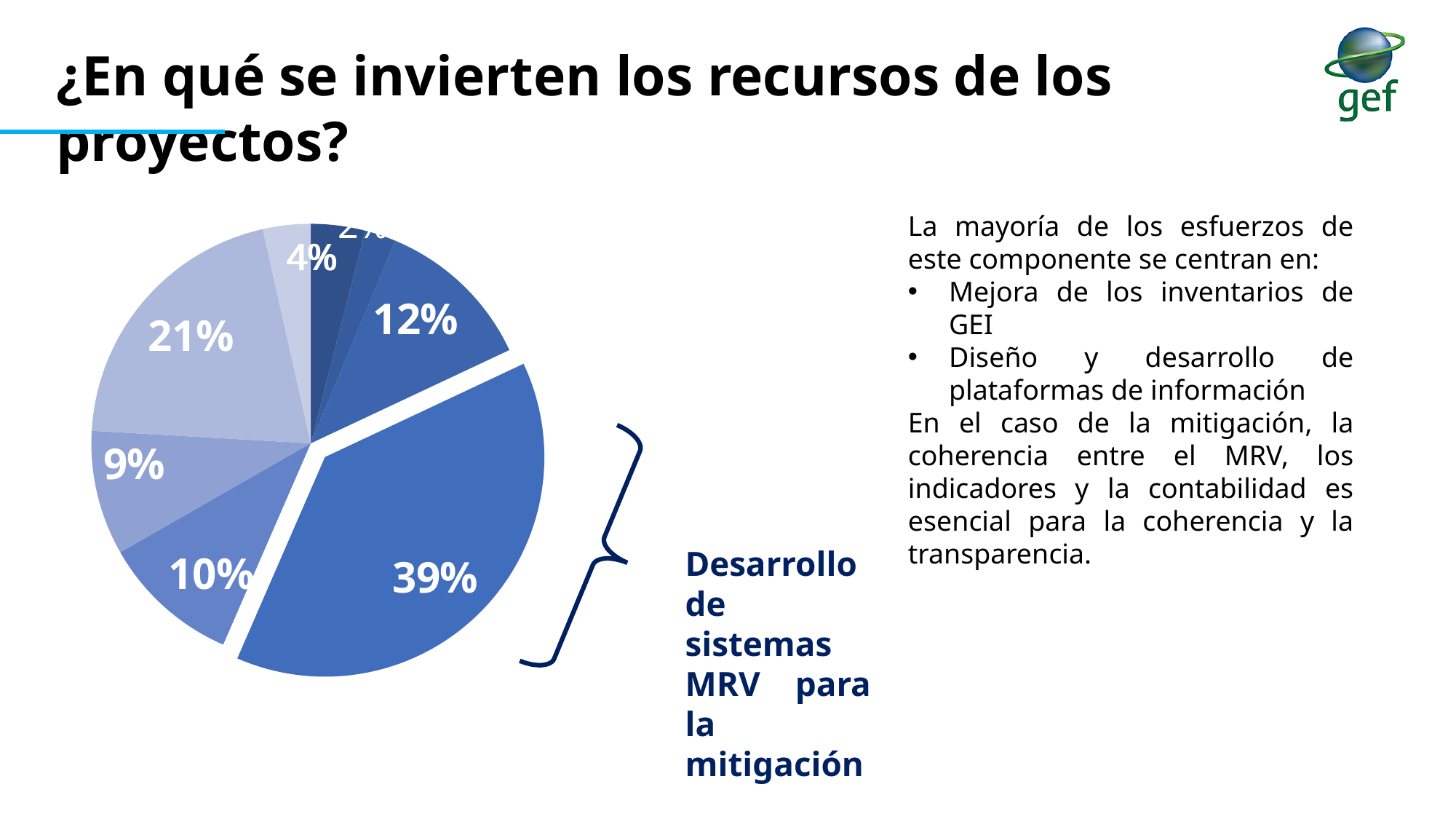
What is the combined share of the slices labelled 39% and 12%? 51% What is the difference between the slice labelled 12% and the slice labelled 4%? 8% What is the difference between the largest slice (39%) and the slice labelled 21%? 18% Which slice of the pie chart is pulled out (exploded) from the rest? the 39% slice (Desarrollo de sistemas MRV para la mitigación) Which is larger: the slice labelled 12% or the slice labelled 21%? 21% What text does the bracket next to the pie chart point to? Desarrollo de sistemas MRV para la mitigación What share of the pie does the slice labelled "Desarrollo de sistemas MRV para la mitigación" represent? 39% What is the value of the largest slice in the pie chart? 39% What is the value of the second-largest slice in the pie chart? 21% What kind of chart is shown on the slide? pie chart Which is larger: the slice labelled 10% or the slice labelled 9%? 10%